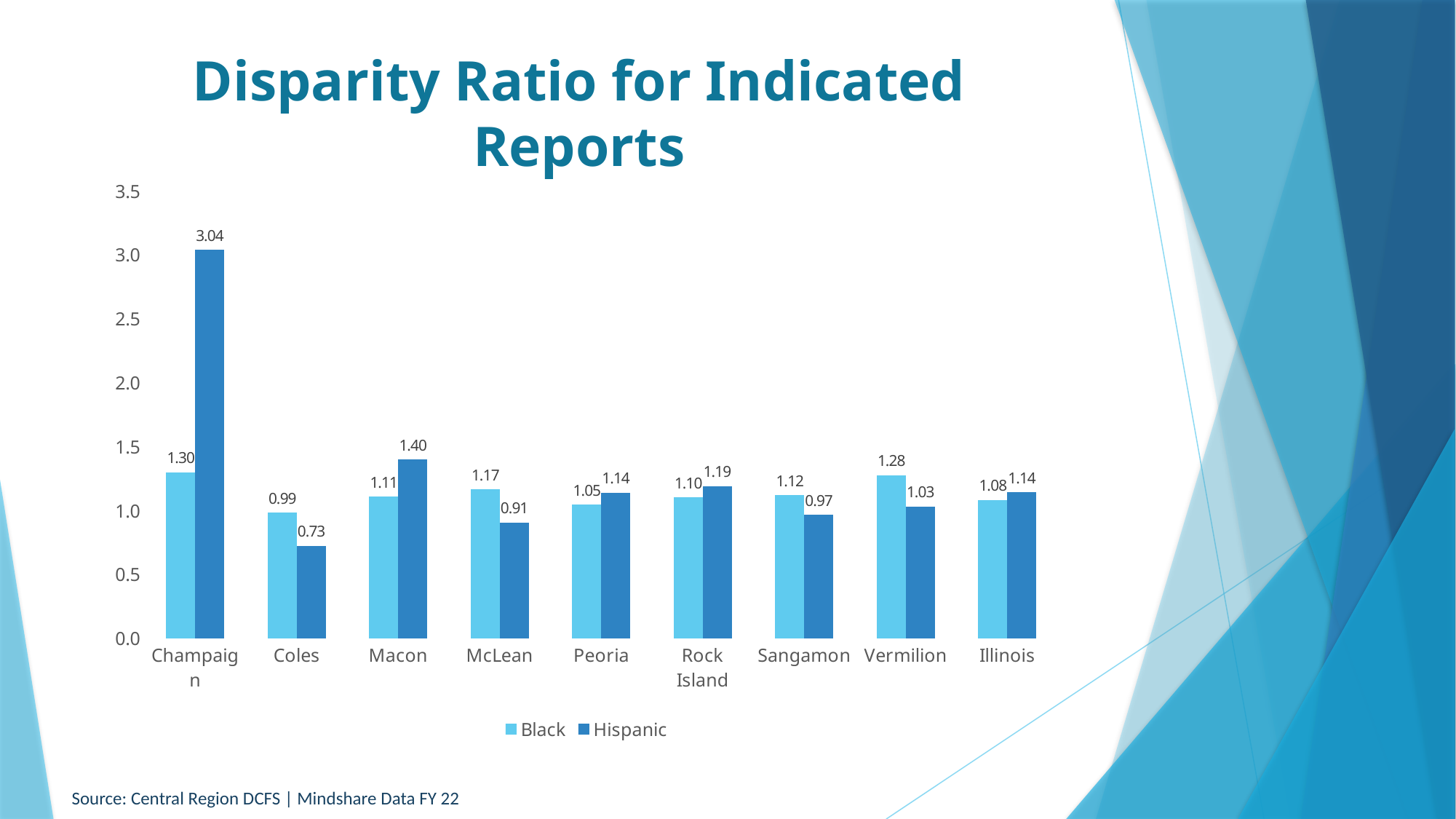
Is the Hispanic value for Champaign greater or less than 3.0? greater What is the difference between the Hispanic and Black disparity ratios for Champaign? 1.74 What is the Hispanic disparity ratio for Champaign? 3.04 How many categories are shown on the x axis? 9 What is the Black disparity ratio for Vermilion? 1.28 Which category has the lowest Black disparity ratio? Coles What is the Hispanic disparity ratio for Coles? 0.73 What is the title of the chart? Disparity Ratio for Indicated Reports How many series does the legend list? 2 What kind of chart is shown on the slide? Bar chart Which category has the highest Hispanic disparity ratio? Champaign Which is larger for McLean, the Black or the Hispanic disparity ratio? Black